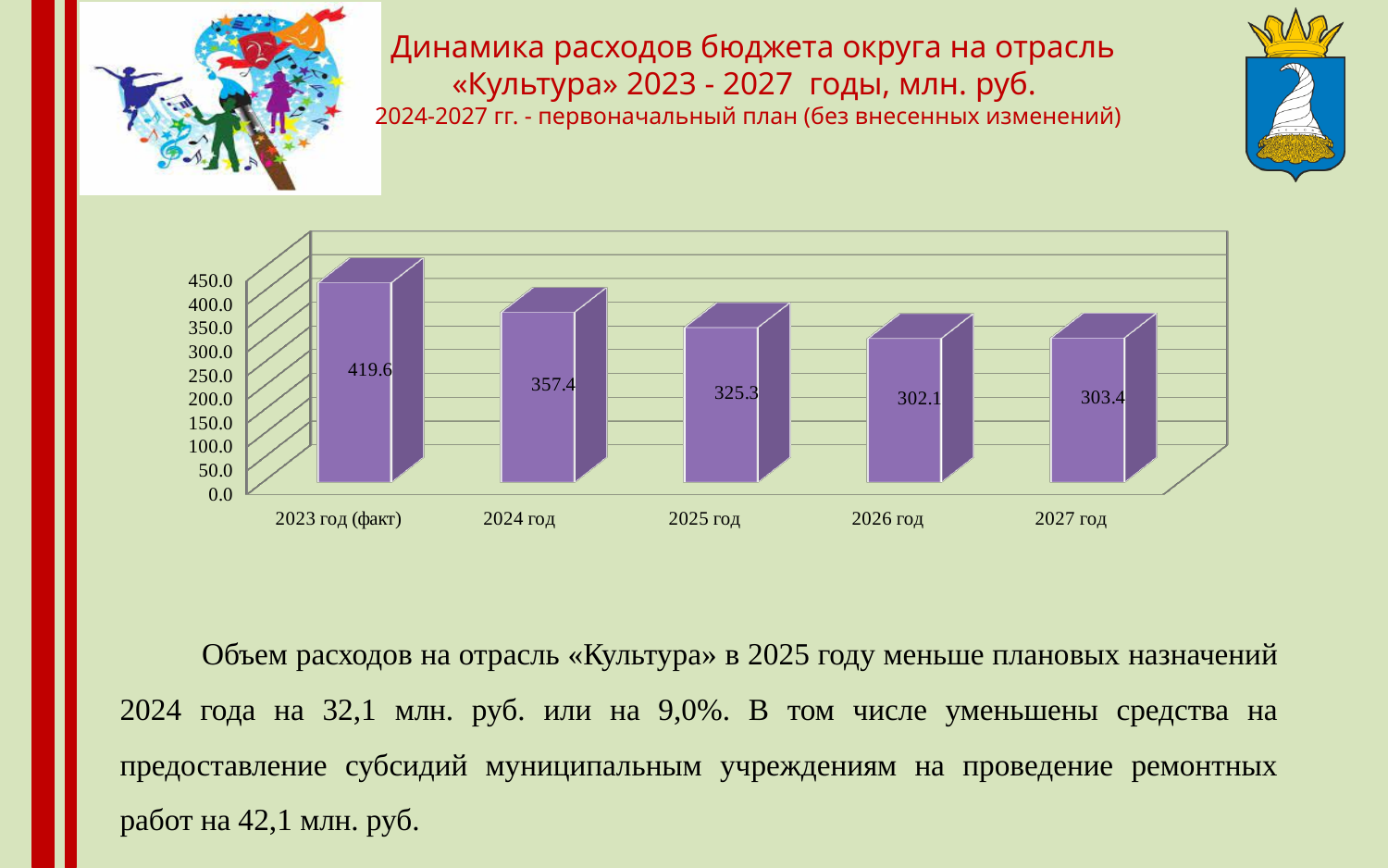
What is the value for 2023 год (факт)? 419.6 Which year has the highest value? 2023 год (факт) Is the value for 2023 год (факт) greater or less than 400.0? greater Do the values generally rise or fall from 2023 год (факт) to 2026 год? fall Which is larger, the value for 2024 год or the value for 2026 год? 2024 год How many years are shown on the x axis? 5 What is the value for 2025 год? 325.3 What kind of chart is shown on the slide? bar chart What is the difference between the values for 2023 год (факт) and 2027 год? 116.2 Which year has the lowest value? 2026 год What is the difference between the values for 2024 год and 2025 год? 32.1 What is the value for 2027 год? 303.4